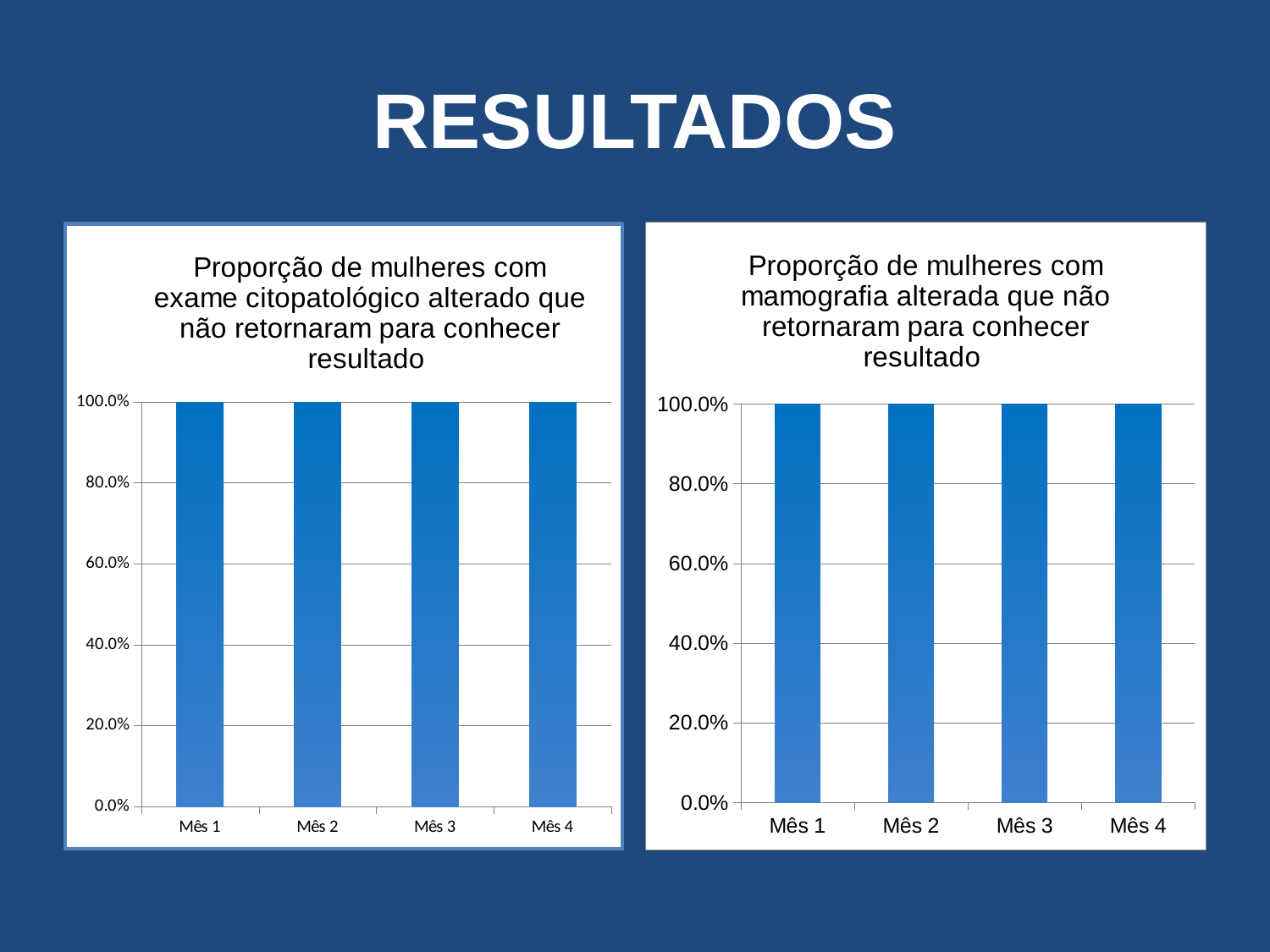
What kind of chart is the right chart (mamografia alterada)? Bar chart In the left chart (exame citopatológico alterado), do the values rise, fall, or stay the same from Mês 1 to Mês 4? Stay the same What kind of chart is the left chart (exame citopatológico alterado)? Bar chart What is the title of the right chart? Proporção de mulheres com mamografia alterada que não retornaram para conhecer resultado In the left chart (exame citopatológico alterado), what is the value for Mês 1? 100.0% How many bars are plotted in the right chart (mamografia alterada)? 4 In the right chart (mamografia alterada), is the value for Mês 3 greater or less than 80.0%? greater In the left chart (exame citopatológico alterado), what is the difference between the values for Mês 2 and Mês 4? 0.0% How many categories are shown on the x axis of the left chart (exame citopatológico alterado)? 4 In the right chart (mamografia alterada), what is the value for Mês 4? 100.0% In the right chart (mamografia alterada), what is the value for Mês 2? 100.0% In the left chart (exame citopatológico alterado), what is the value for Mês 3? 100.0%